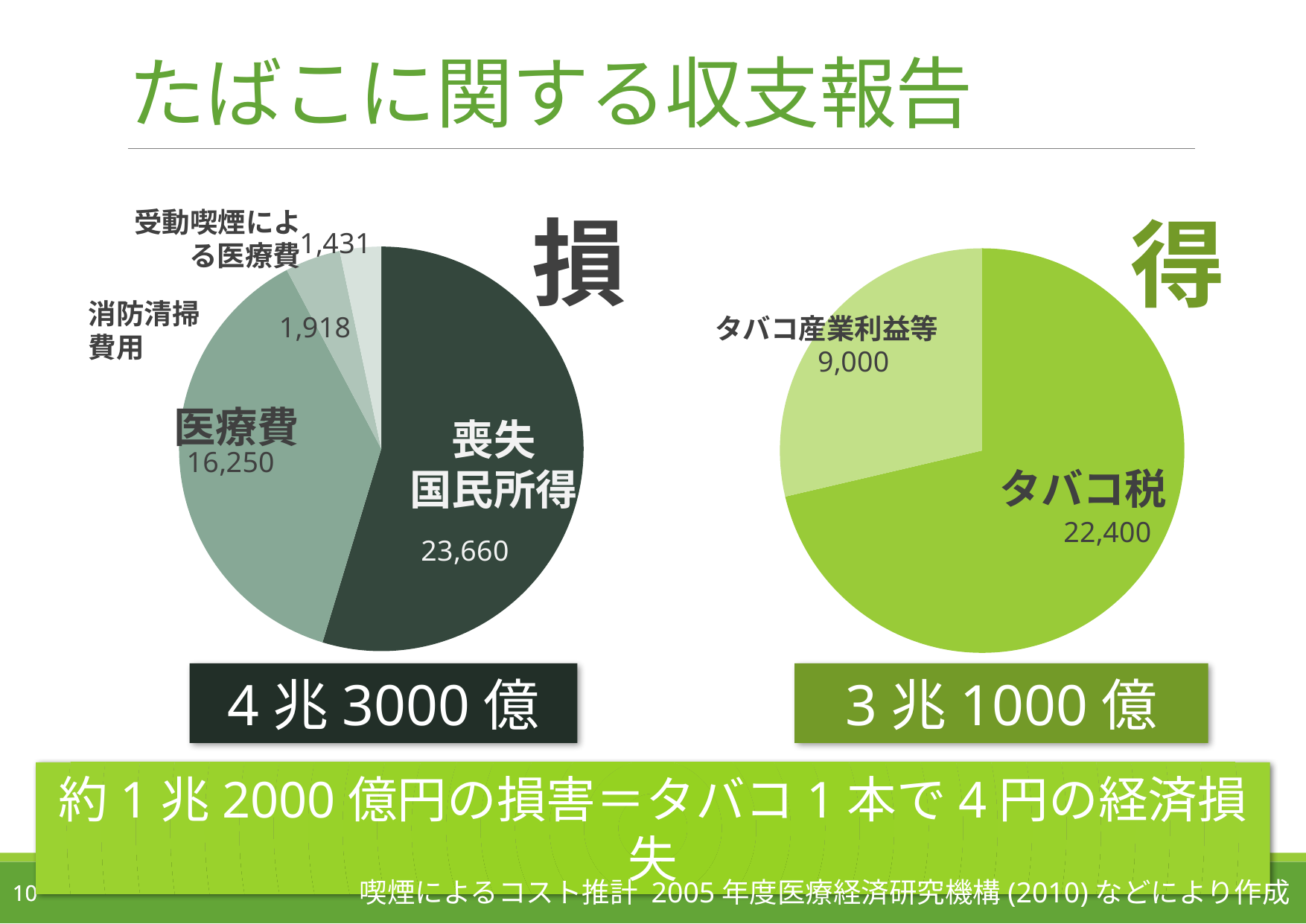
What type of chart is the left chart labelled 損? Pie chart In the right pie chart (得), which is larger, タバコ税 or タバコ産業利益等? タバコ税 In the right pie chart (得), what is the value for タバコ税? 22,400 In the left pie chart (損), what is the difference between 喪失国民所得 and 医療費? 7,410 In the left pie chart (損), what is the value for 医療費? 16,250 In the left pie chart (損), how many slices are there? 4 In the left pie chart (損), what is the value for 喪失国民所得? 23,660 In the left pie chart (損), what is the value for 受動喫煙による医療費? 1,431 In the left pie chart (損), which slice is the smallest? 受動喫煙による医療費 In the right pie chart (得), what is the value for タバコ産業利益等? 9,000 In the left pie chart (損), which slice is the largest? 喪失国民所得 In the left pie chart (損), what is the value for 消防清掃費用? 1,918